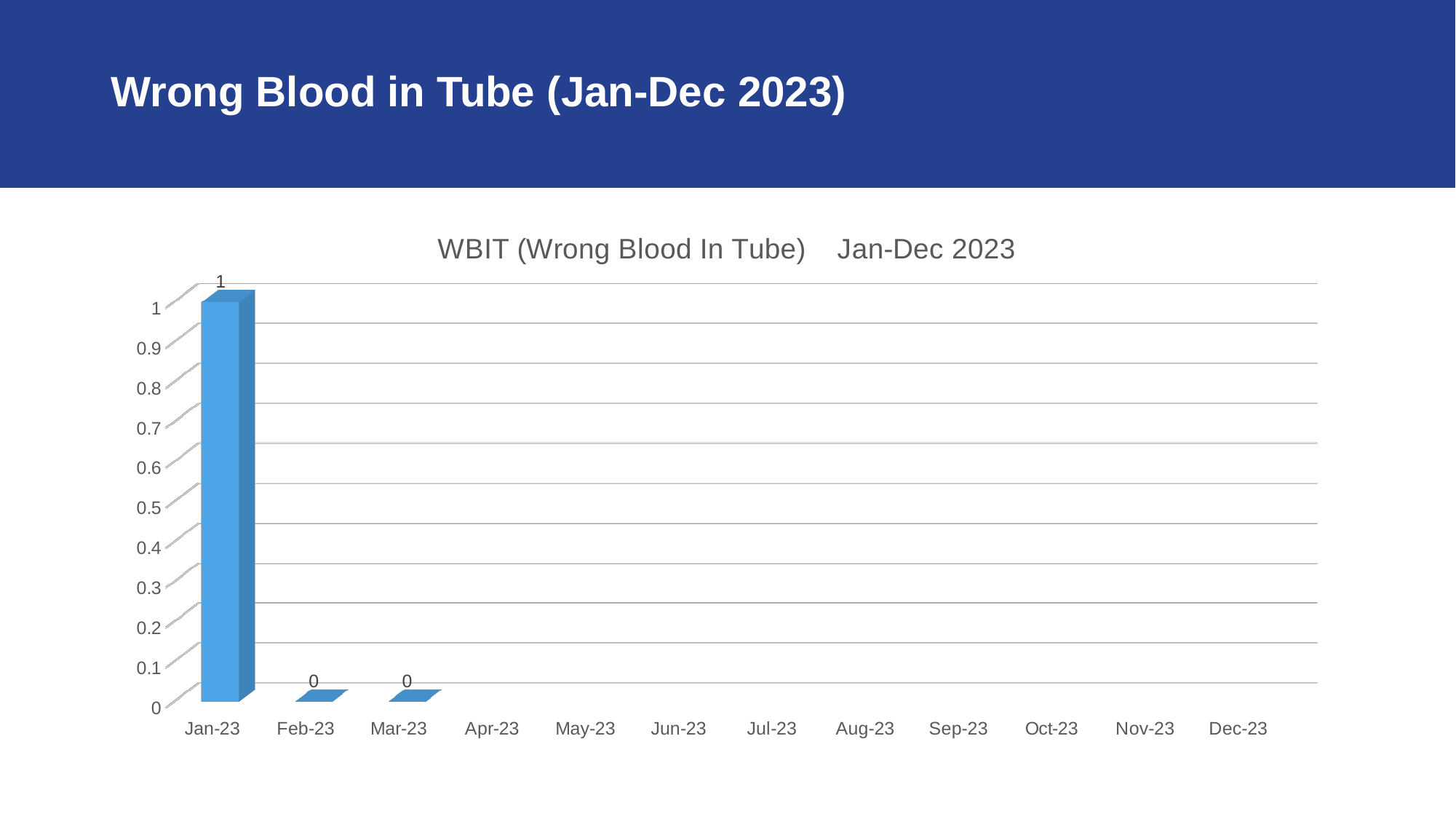
How many months are shown on the x axis? 12 What is the value for Mar-23? 0 What is the title of the chart? WBIT (Wrong Blood In Tube) Jan-Dec 2023 What kind of chart is shown on the slide? bar chart What is the value for Feb-23? 0 Which month has the highest value? Jan-23 How many months have a data label of 0? 2 What is the difference between the values for Jan-23 and Feb-23? 1 What is the value for Jan-23? 1 Which is larger, the value for Jan-23 or the value for Mar-23? Jan-23 What is the highest value shown on the y axis? 1 Do the values rise or fall from Jan-23 to Mar-23? fall